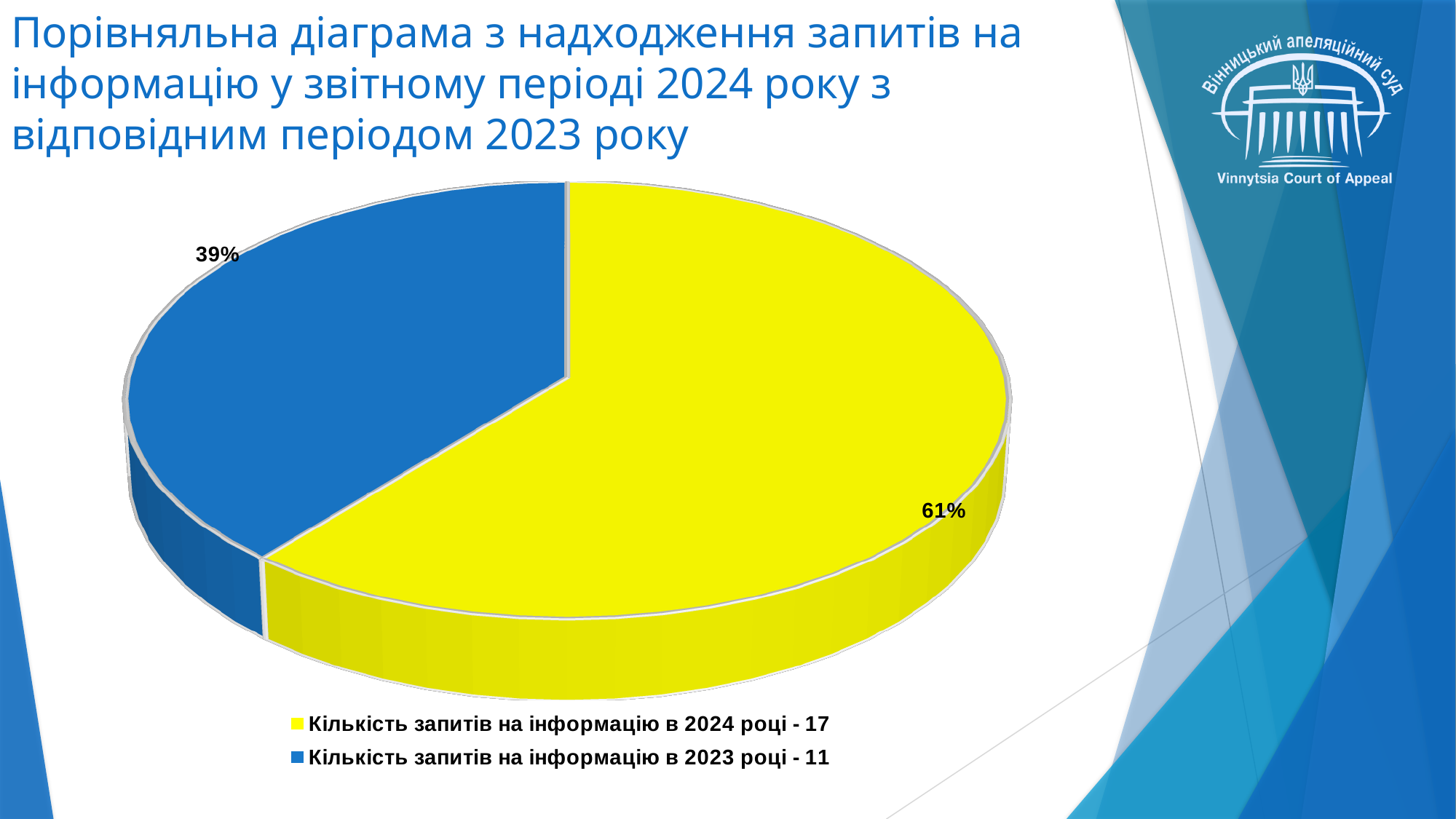
What kind of chart is shown on the slide? pie chart How many entries does the legend list? 2 How many slices does the pie chart have? 2 Which year has the larger share of the pie, 2024 or 2023? 2024 What is the difference in percentage points between the 2024 slice and the 2023 slice? 22 What percentage share is shown for the blue slice (requests for information in 2023)? 39% According to the legend, how many requests for information were received in 2023? 11 What percentage share is shown for the yellow slice (requests for information in 2024)? 61% Which slice is the smallest in the pie chart? Кількість запитів на інформацію в 2023 році - 11 By how many requests did the number of requests in 2024 exceed the number in 2023? 6 According to the legend, how many requests for information were received in 2024? 17 Which colour represents the requests for information in 2023? blue